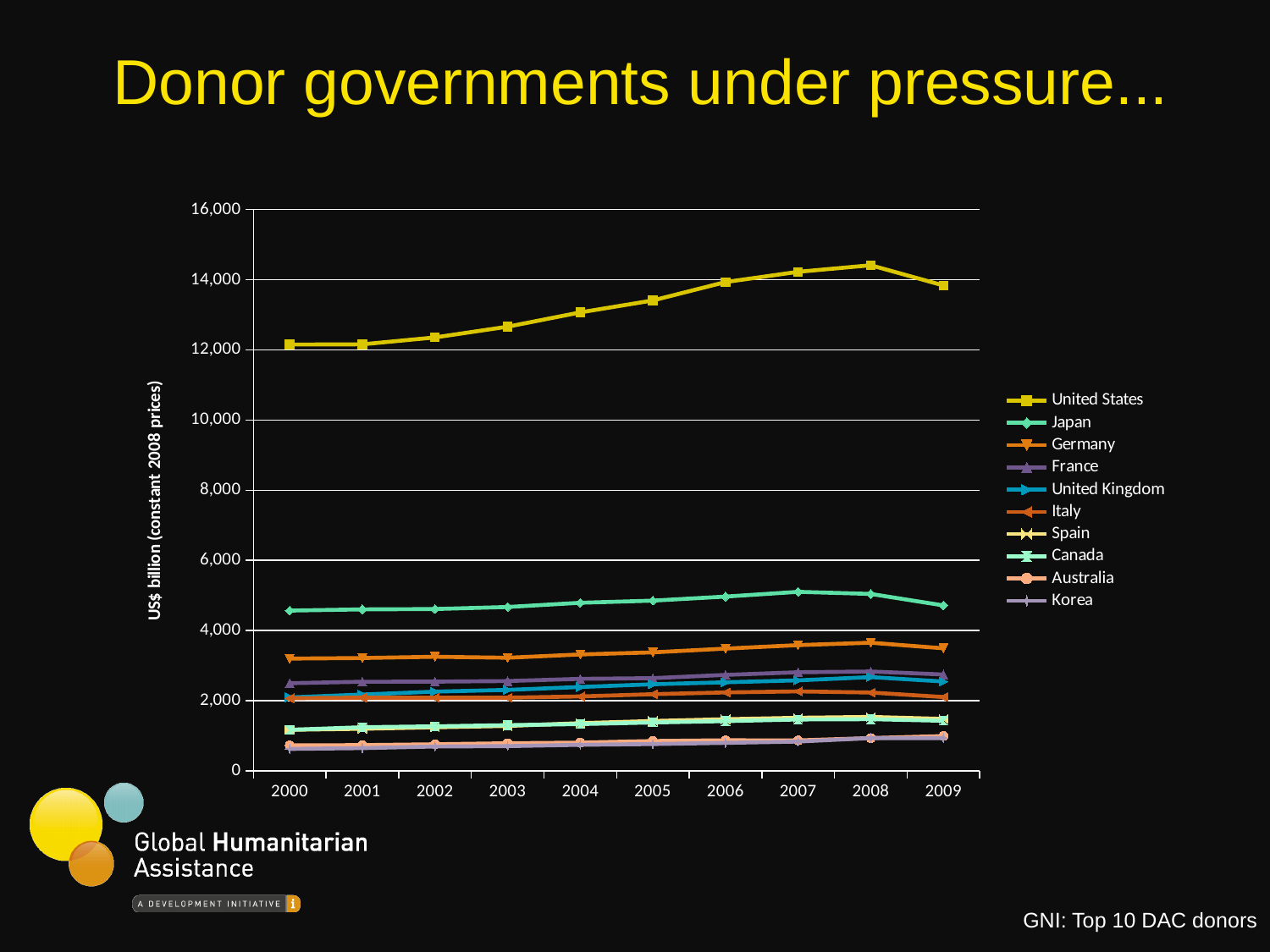
Is the value for the United States in 2008 greater or less than 14,000? greater Is the value for Germany in 2009 greater or less than 4,000? less Does the United States line rise or fall between 2000 and 2008? rise How many series does the legend list? 10 Is the value for Japan in 2007 greater or less than 6,000? less What is the label on the y axis? US$ billion (constant 2008 prices) In which year does the United States line reach its peak? 2008 How many years are shown along the x axis? 10 Which donor has the highest values across the whole period? United States Which is larger in 2005, the value for Japan or the value for Germany? Japan What kind of chart is shown on the slide? line chart Does the United States line rise or fall between 2008 and 2009? fall